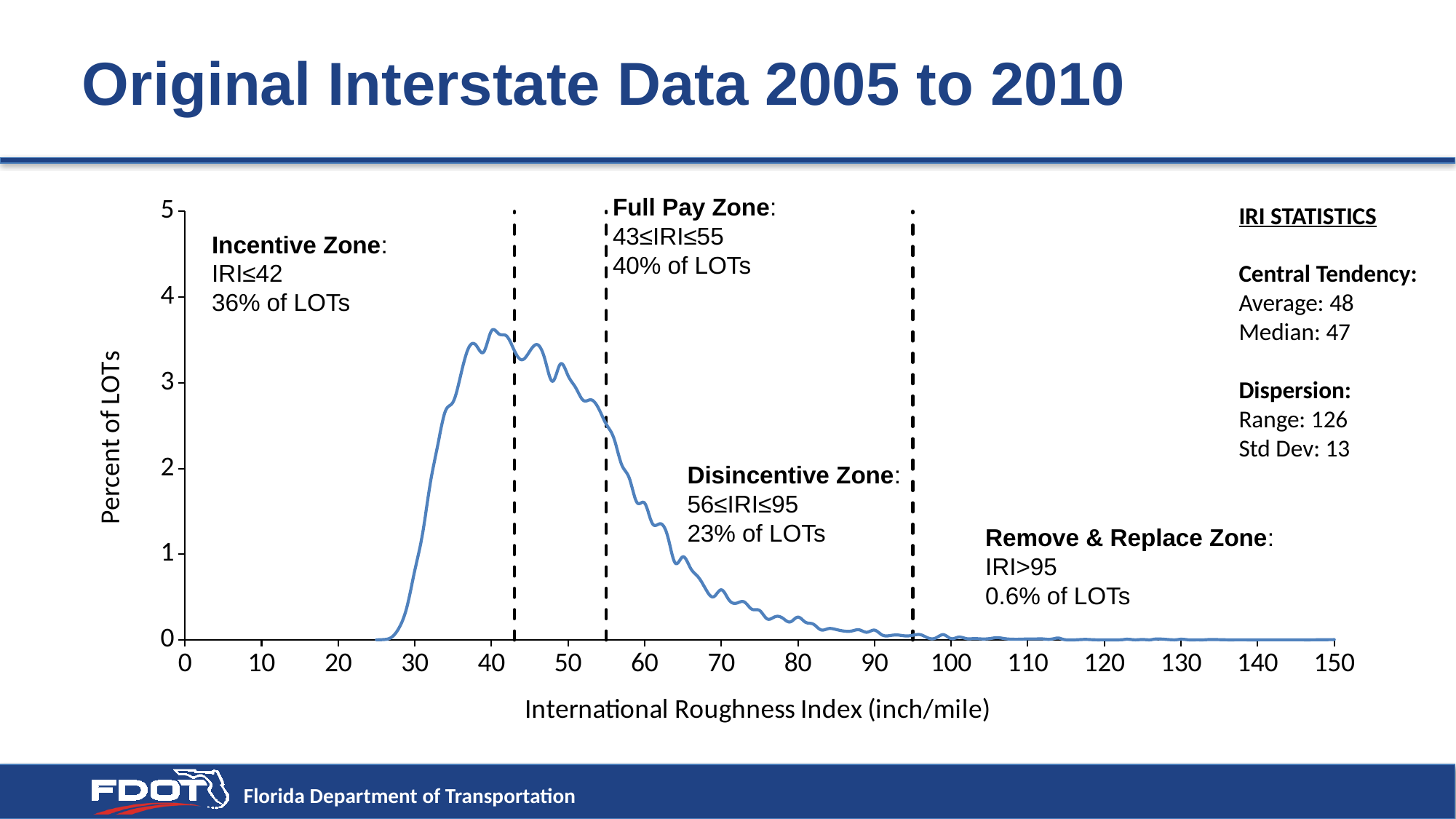
What percentage of LOTs fall in the Remove & Replace Zone? 0.6% of LOTs What percentage of LOTs fall in the Full Pay Zone? 40% of LOTs Which zone contains the smallest share of LOTs? Remove & Replace Zone What percentage of LOTs fall in the Disincentive Zone? 23% of LOTs What percentage of LOTs fall in the Incentive Zone? 36% of LOTs Which zone contains the largest share of LOTs? Full Pay Zone What kind of chart is shown on the slide? line chart Does the Percent of LOTs rise or fall as IRI increases from 50 to 90? fall How many percentage points more LOTs are in the Full Pay Zone than in the Incentive Zone? 4 What is the average IRI reported in the IRI Statistics box? 48 Is the Percent of LOTs at an IRI of 40 greater or less than 3? greater Is the Percent of LOTs at an IRI of 70 greater or less than 1? less